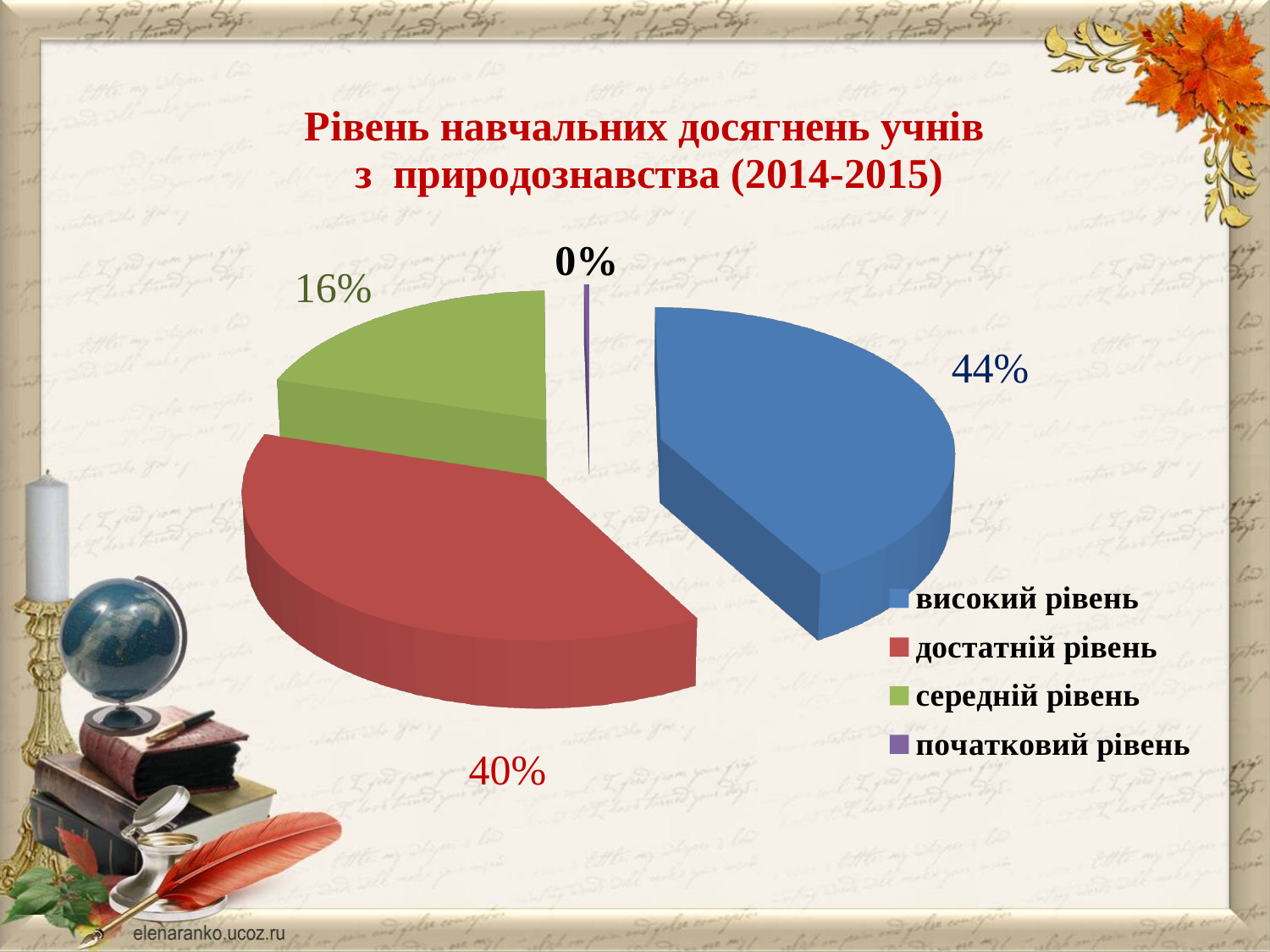
What kind of chart is shown on the slide? pie chart Which category has the largest share of the pie? високий рівень What is the value for достатній рівень? 40% What is the value for високий рівень? 44% Which is larger, the value for достатній рівень or the value for середній рівень? достатній рівень What is the value for середній рівень? 16% What colour is the slice for достатній рівень? red What is the difference between the values for високий рівень and середній рівень? 28% What is the value for початковий рівень? 0% Which category has the smallest share of the pie? початковий рівень How many categories does the legend list? 4 What is the title of the chart? Рівень навчальних досягнень учнів з природознавства (2014-2015)